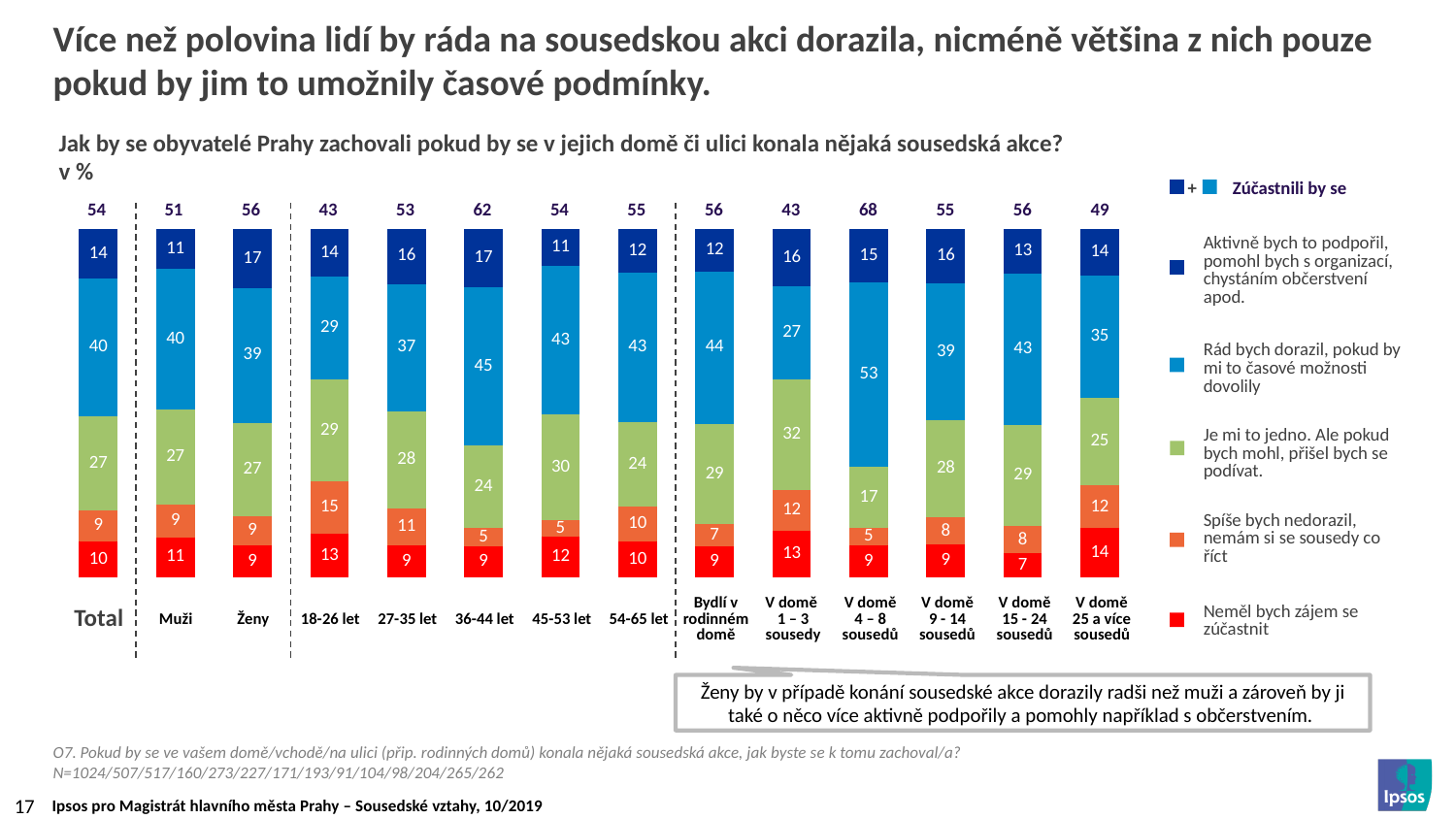
What is the difference between the 'Zúčastnili by se' values for Ženy and Muži? 5 What is the value of 'Neměl bych zájem se zúčastnit' for the 36-44 let group? 9 Which is larger: the 'Neměl bych zájem se zúčastnit' value for Muži or for Ženy? Muži How many response categories does the legend list (excluding the combined 'Zúčastnili by se' line)? 5 Which category has the highest value for 'Je mi to jedno. Ale pokud bych mohl, přišel bych se podívat'? V domě 1 – 3 sousedy What is the difference between the 'Rád bych dorazil, pokud by mi to časové možnosti dovolily' values for 36-44 let and 18-26 let? 16 What is the value of 'Rád bych dorazil, pokud by mi to časové možnosti dovolily' for the Total bar? 40 What kind of chart is shown on the slide? Stacked bar chart What is the total of all segments in the Total bar? 100 Which category has the highest 'Zúčastnili by se' value shown above the bars? V domě 4 – 8 sousedů How many categories (bars) are plotted along the x axis? 14 What is the 'Zúčastnili by se' value shown above the bar for Ženy? 56